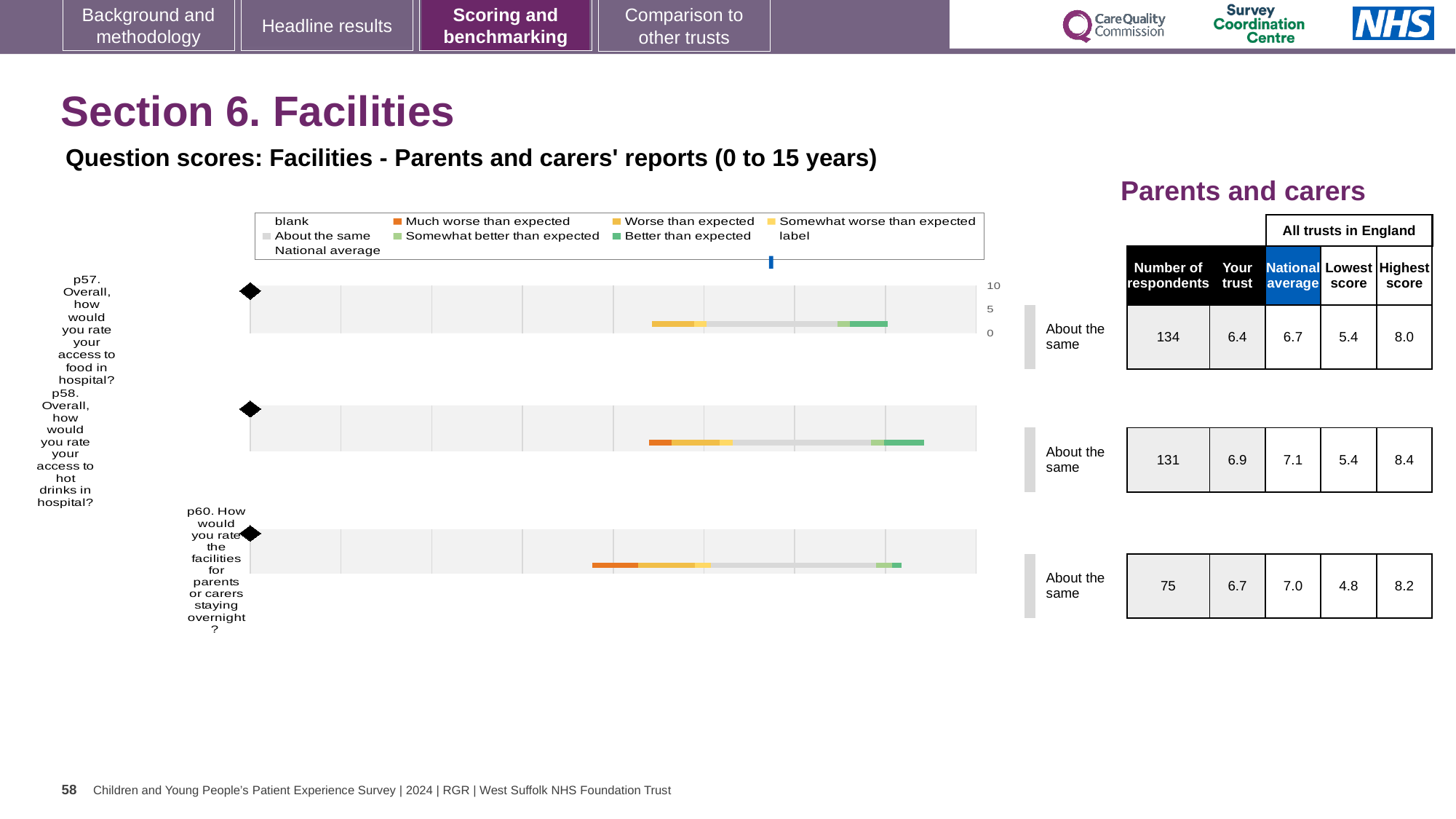
What is the highest score among all trusts in England for p58? 8.4 How many respondents answered p60 (facilities for parents or carers staying overnight)? 75 How many questions (p57, p58, p60) are plotted on the slide? 3 What is the lowest score among all trusts in England for p60? 4.8 What is the difference between the highest and lowest scores for p57? 2.6 What kind of chart is used to show the question scores on this slide? bar chart Which question has the highest 'Your trust' score? p58 Which question has the fewest respondents? p60 What benchmark category is shown next to the p60 chart? About the same What is the national average score for p58 (access to hot drinks in hospital)? 7.1 What is the 'Your trust' score for p57 (access to food in hospital)? 6.4 For p57, which is larger: the 'Your trust' score or the national average? National average